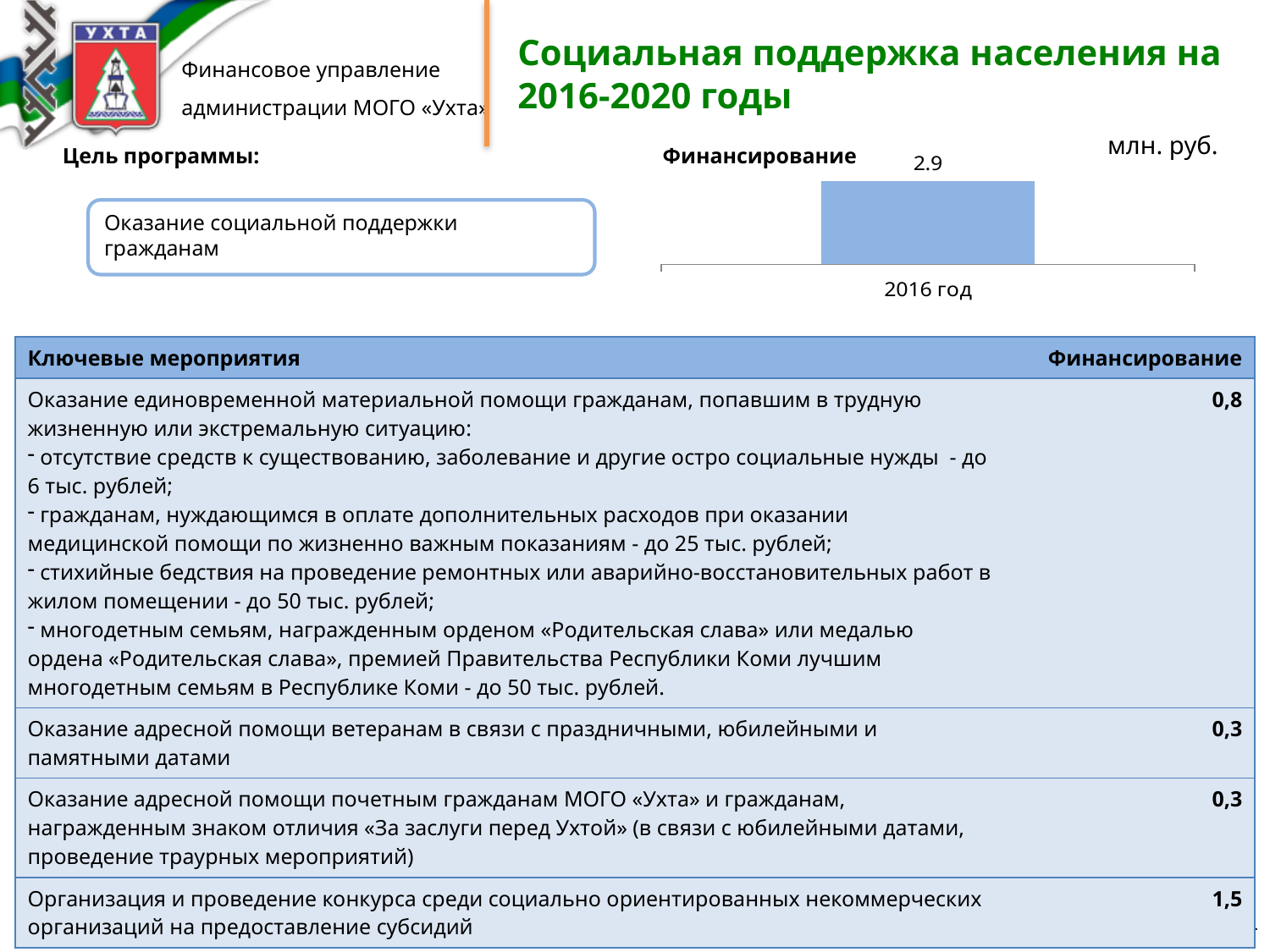
What is the value of the bar for 2016 год in the Финансирование chart? 2.9 What unit of measurement is indicated for the Финансирование chart? млн. руб. What kind of chart is shown under the heading Финансирование? bar chart What is the data label printed above the single bar in the chart? 2.9 How many bars are plotted in the Финансирование chart? 1 Which year is shown on the x axis of the Финансирование chart? 2016 год